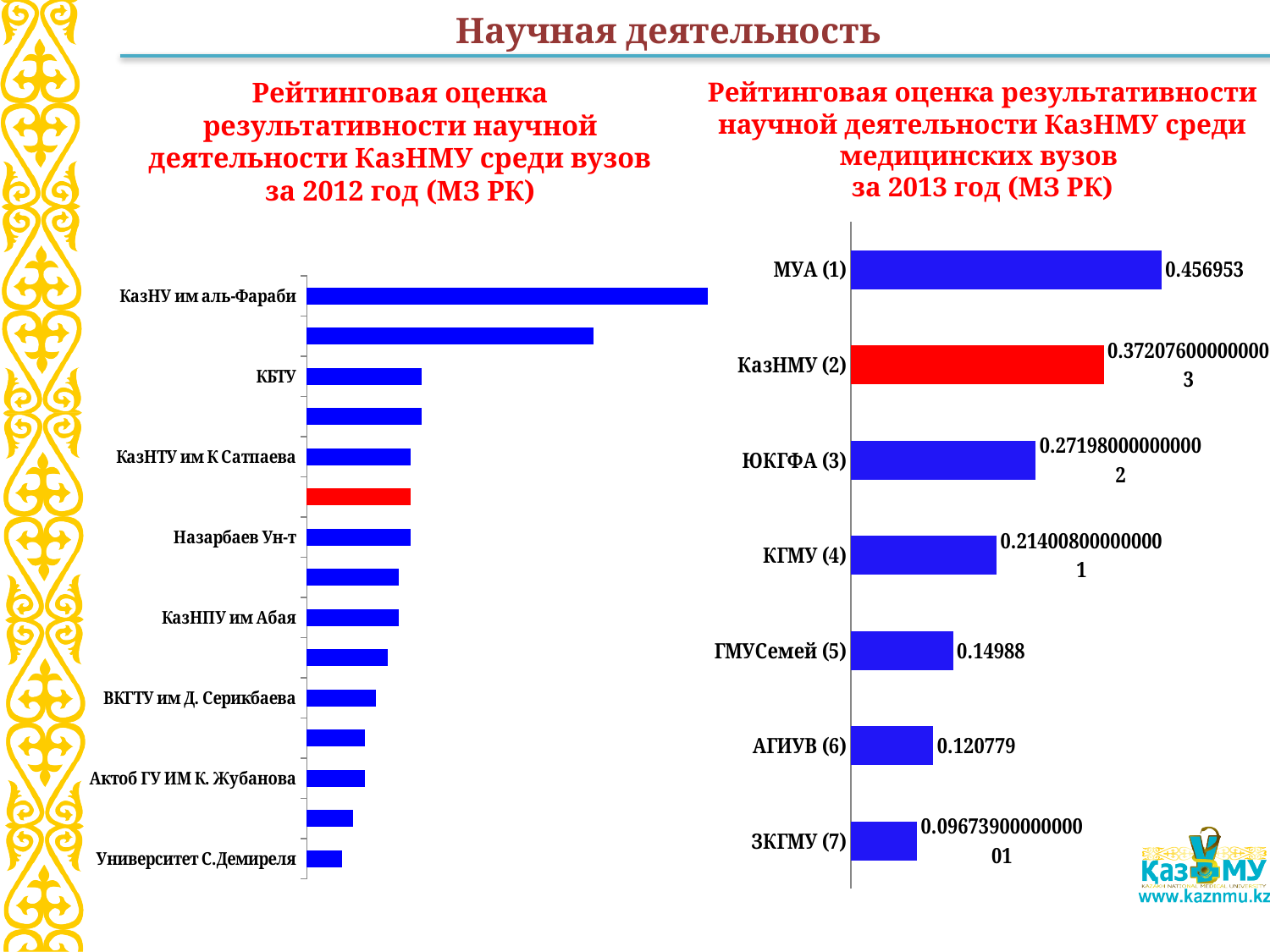
In the right chart (2013 rating among medical universities), what is the value for АГИУВ (6)? 0.120779 In the left chart (2012 rating among universities), which university has the longest bar? КазНУ им аль-Фараби What type of chart is the left chart (2012 rating among universities)? bar chart In the right chart (2013 rating among medical universities), which university has the highest value? МУА (1) In the left chart (2012 rating among universities), which labelled university has the shortest bar? Университет С.Демиреля In the right chart (2013 rating among medical universities), what is the difference between the values for МУА (1) and ГМУСемей (5)? 0.307073 In the right chart (2013 rating among medical universities), how many universities are shown? 7 In the right chart (2013 rating among medical universities), which bar is coloured red? КазНМУ (2) In the right chart (2013 rating among medical universities), what is the value for МУА (1)? 0.456953 In the right chart (2013 rating among medical universities), do the values increase or decrease going from the top bar to the bottom bar? decrease In the right chart (2013 rating among medical universities), what is the value for ГМУСемей (5)? 0.14988 In the right chart (2013 rating among medical universities), which university has the lowest value? ЗКГМУ (7)